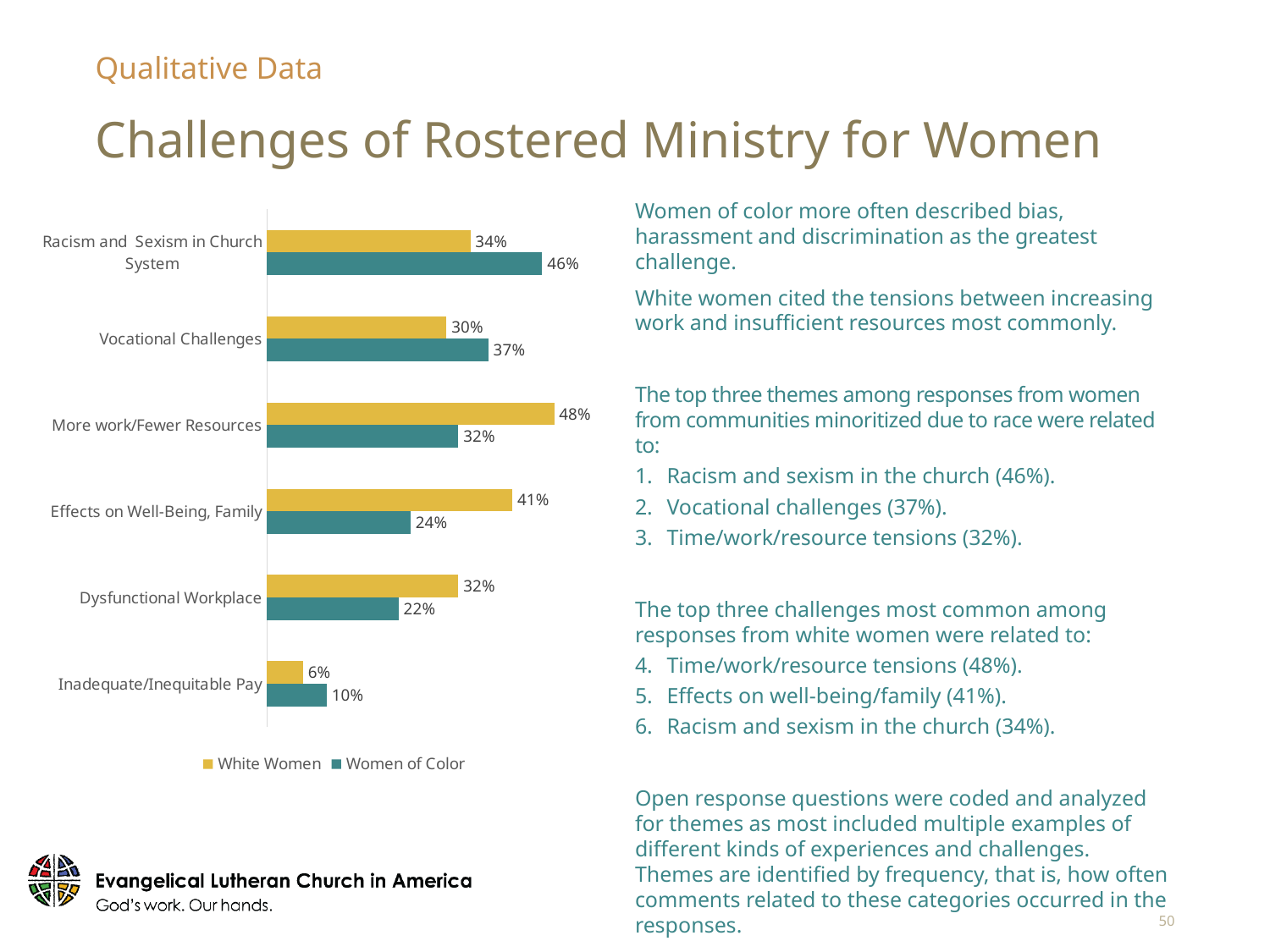
How many series does the legend list? 2 What is the difference between Women of Color and White Women for Racism and Sexism in Church System? 12% What percentage of White Women cited More work/Fewer Resources as a challenge? 48% Which category has the highest value for Women of Color? Racism and Sexism in Church System Which colour represents Women of Color in the chart? Teal How many challenge categories are shown in the chart? 6 What type of chart is shown on the slide? Bar chart Which category has the lowest value for White Women? Inadequate/Inequitable Pay For Vocational Challenges, which group has the larger value, White Women or Women of Color? Women of Color What is the value for Women of Color for Inadequate/Inequitable Pay? 10% What percentage of Women of Color cited Racism and Sexism in Church System? 46% What is the difference between White Women and Women of Color for Effects on Well-Being, Family? 17%